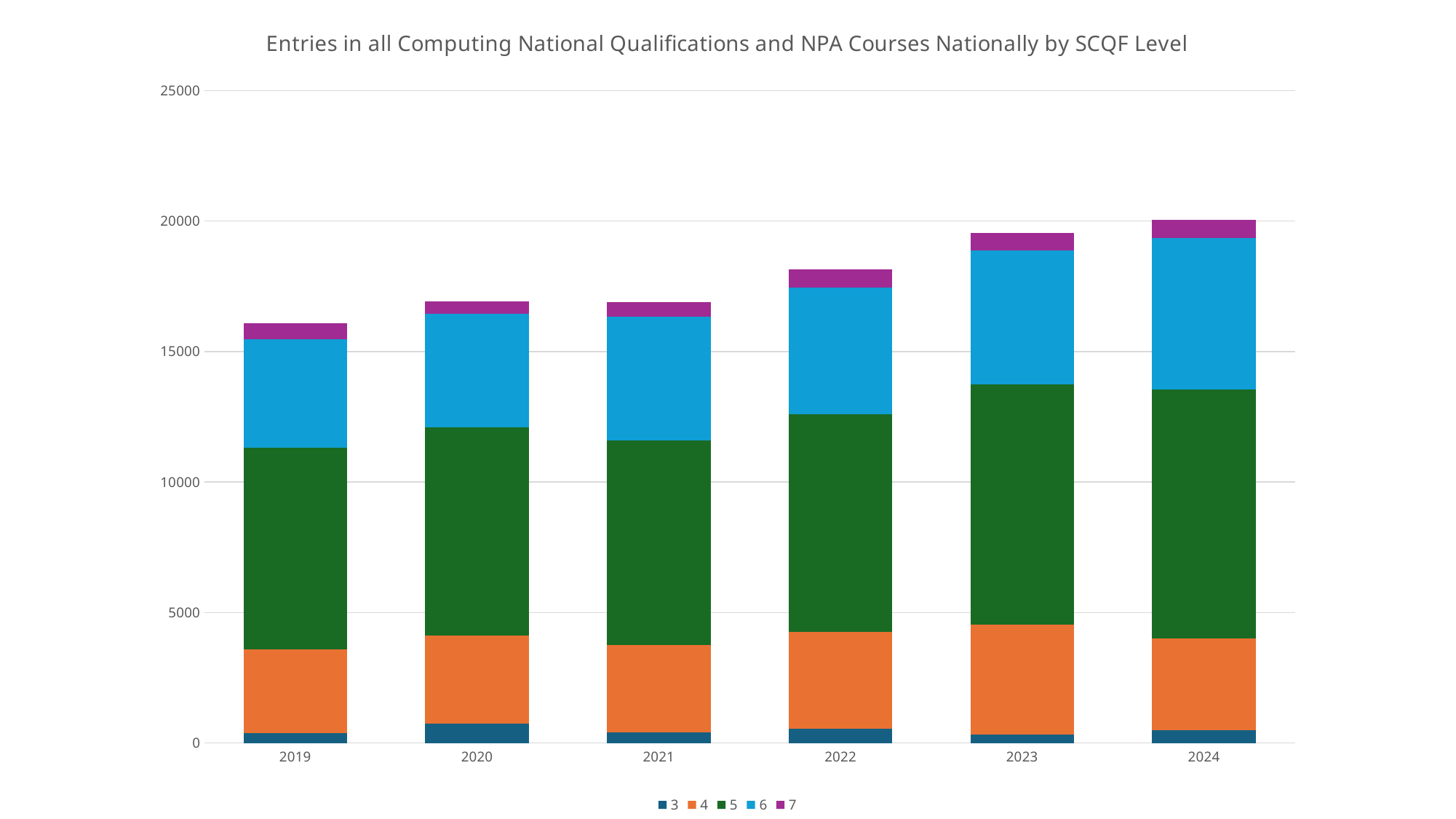
What is the title of the chart? Entries in all Computing National Qualifications and NPA Courses Nationally by SCQF Level Which year has the lowest total number of entries? 2019 What kind of chart is shown on the slide? Stacked bar chart Is the total number of entries for 2019 greater or less than 15000? greater Which year has a larger total number of entries, 2019 or 2023? 2023 Is the total number of entries for 2024 greater or less than 15000? greater Which year has the highest total number of entries? 2024 How many years are shown along the x axis? 6 Which SCQF levels are listed in the legend? 3, 4, 5, 6, 7 Is the total number of entries for 2022 greater or less than 20000? less How many series does the legend list? 5 Do the total entries generally rise or fall from 2019 to 2024? Rise